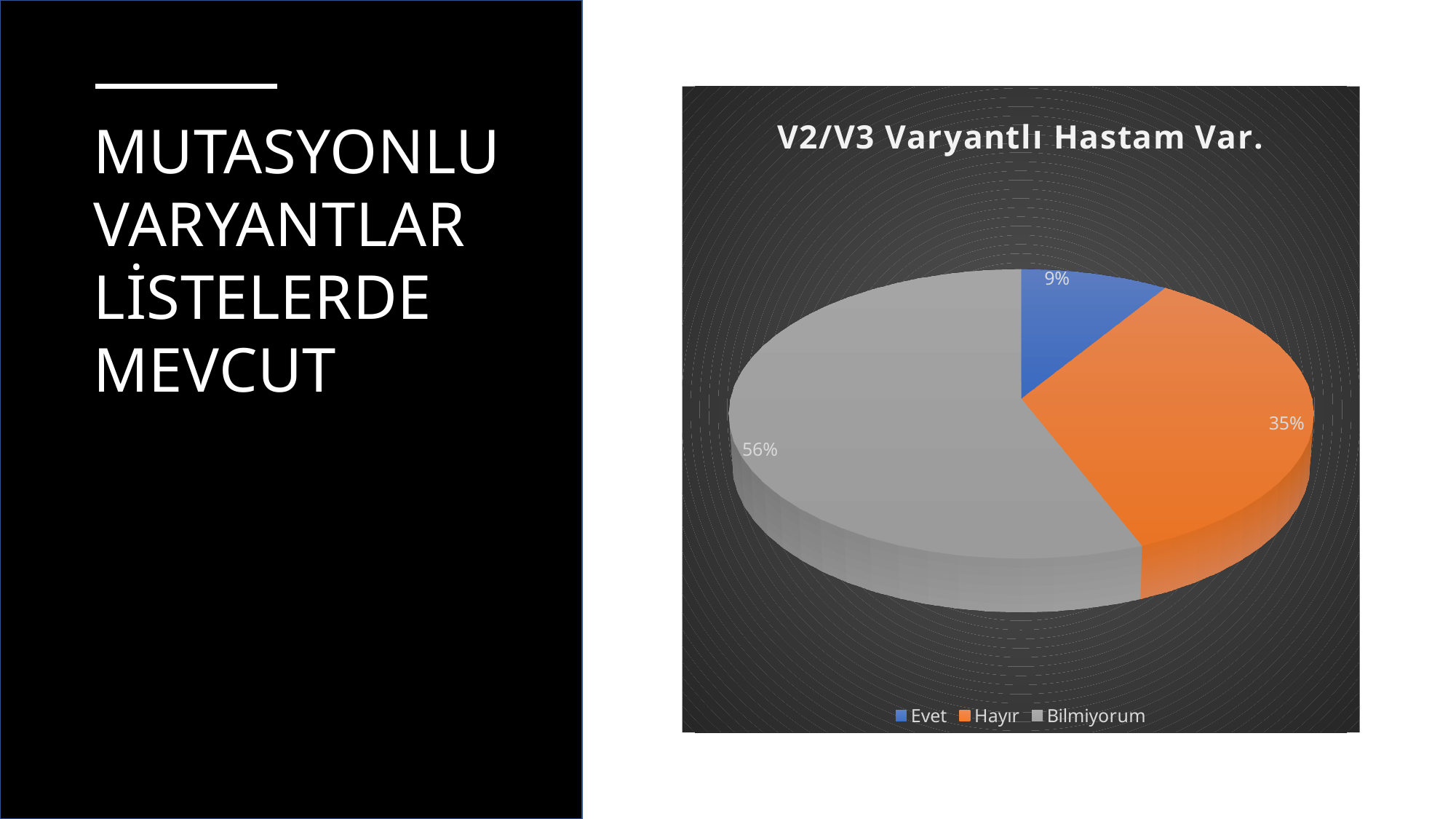
What kind of chart is shown on the slide? Pie chart How many categories does the legend list? 3 What percentage of the pie is labelled for Hayır? 35% What percentage of the pie is labelled for Bilmiyorum? 56% Which is larger, the share for Hayır or the share for Evet? Hayır What percentage of the pie is labelled for Evet? 9% What colour is the Hayır slice? Orange What is the title of the chart? V2/V3 Varyantlı Hastam Var. What is the difference in percentage points between the Bilmiyorum share and the Hayır share? 21 Which category has the largest share of the pie? Bilmiyorum Which category has the smallest share of the pie? Evet